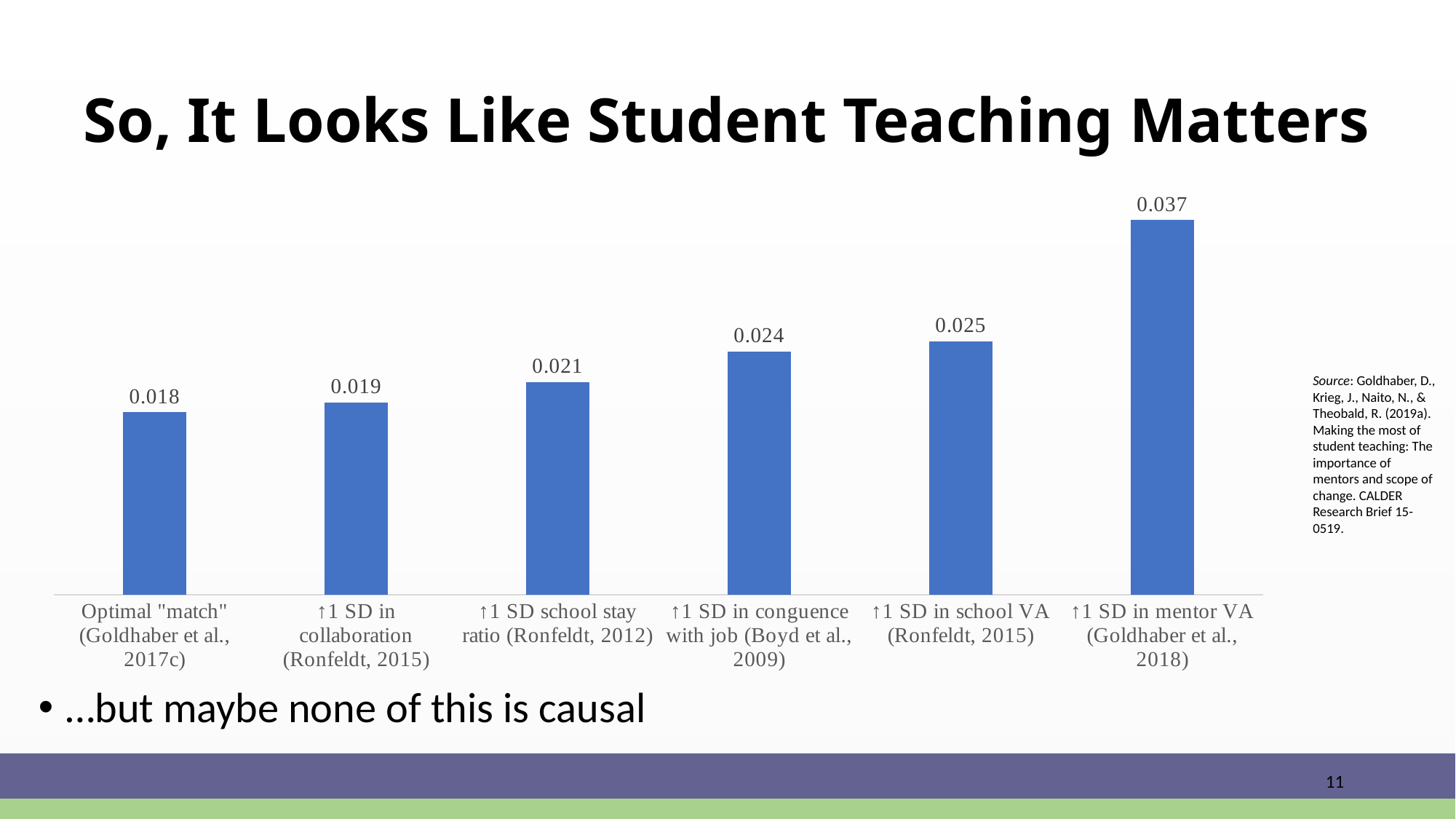
Which category has the lowest value? Optimal "match" (Goldhaber et al., 2017c) What is the value for "↑1 SD in mentor VA (Goldhaber et al., 2018)"? 0.037 What is the value for "↑1 SD school stay ratio (Ronfeldt, 2012)"? 0.021 What kind of chart is shown on the slide? Bar chart What is the value for "↑1 SD in school VA (Ronfeldt, 2015)"? 0.025 What is the value for "Optimal "match" (Goldhaber et al., 2017c)"? 0.018 Which is larger, the value for "↑1 SD in congruence with job (Boyd et al., 2009)" or the value for "↑1 SD school stay ratio (Ronfeldt, 2012)"? ↑1 SD in congruence with job (Boyd et al., 2009) Do the values rise or fall from left to right across the categories? Rise What is the difference between the values for "↑1 SD in mentor VA (Goldhaber et al., 2018)" and "↑1 SD in school VA (Ronfeldt, 2015)"? 0.012 How many categories are shown in the chart? 6 What is the difference between the values for "↑1 SD in congruence with job (Boyd et al., 2009)" and "↑1 SD in collaboration (Ronfeldt, 2015)"? 0.005 Which category has the highest value? ↑1 SD in mentor VA (Goldhaber et al., 2018)